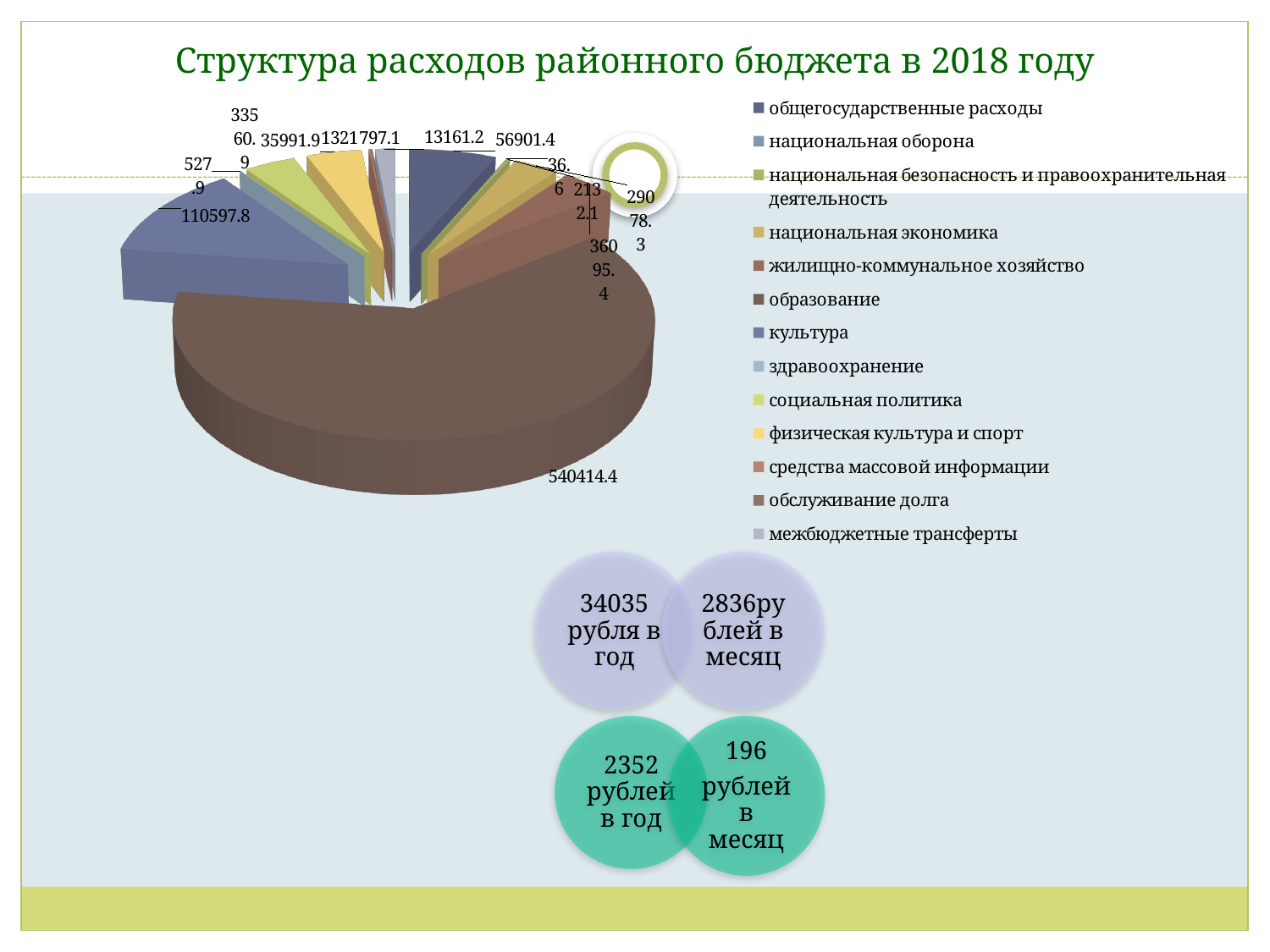
How many categories does the chart's legend list? 13 What is the value shown for культура? 110597.8 Which is larger, the value for образование or the value for культура? образование Which category has the largest slice of the pie? образование What kind of chart is shown on the slide? pie chart What is the first category listed in the legend? общегосударственные расходы What is the difference between the values for образование and культура? 429816.6 Which is larger, the value for культура or the value for общегосударственные расходы? культура What is the value shown for общегосударственные расходы? 56901.4 What is the title of the chart? Структура расходов районного бюджета в 2018 году What is the value shown for the largest slice (образование)? 540414.4